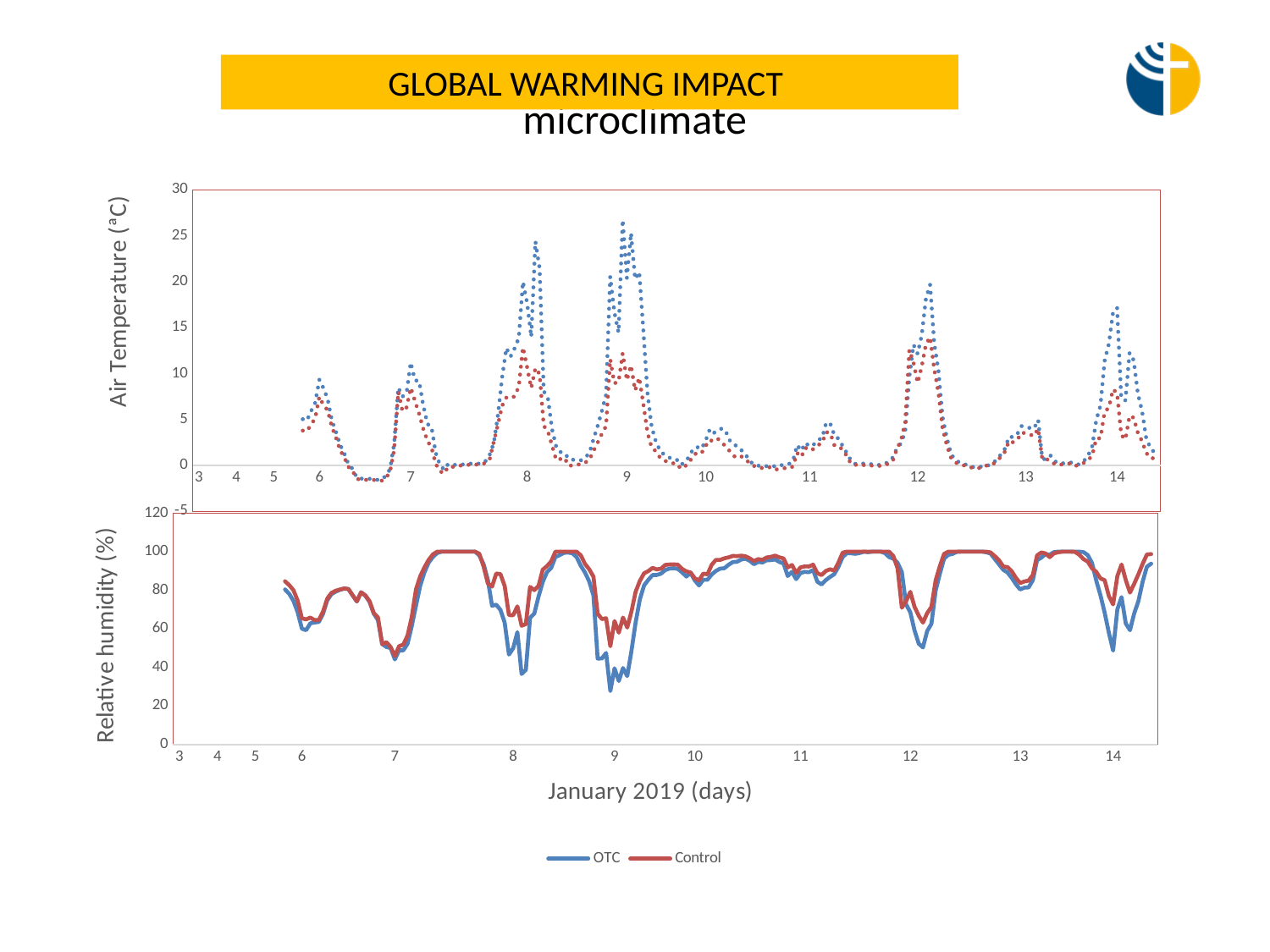
What is the x-axis title shared by the charts? January 2019 (days) In the top chart (Air Temperature), which series reaches the higher peak on day 9, OTC or Control? OTC In the bottom chart (Relative humidity), is the lowest Control value around day 9 greater or less than 40? greater What kind of chart is the bottom chart (Relative humidity)? line chart In the top chart (Air Temperature), is the OTC peak on day 12 greater or less than 15? greater How many series does the legend list? 2 In the bottom chart (Relative humidity), which series drops lower around day 14, OTC or Control? OTC In the top chart (Air Temperature), is the OTC peak on day 9 greater or less than 20? greater What are the two series named in the legend? OTC and Control What kind of chart is the top chart (Air Temperature)? line chart